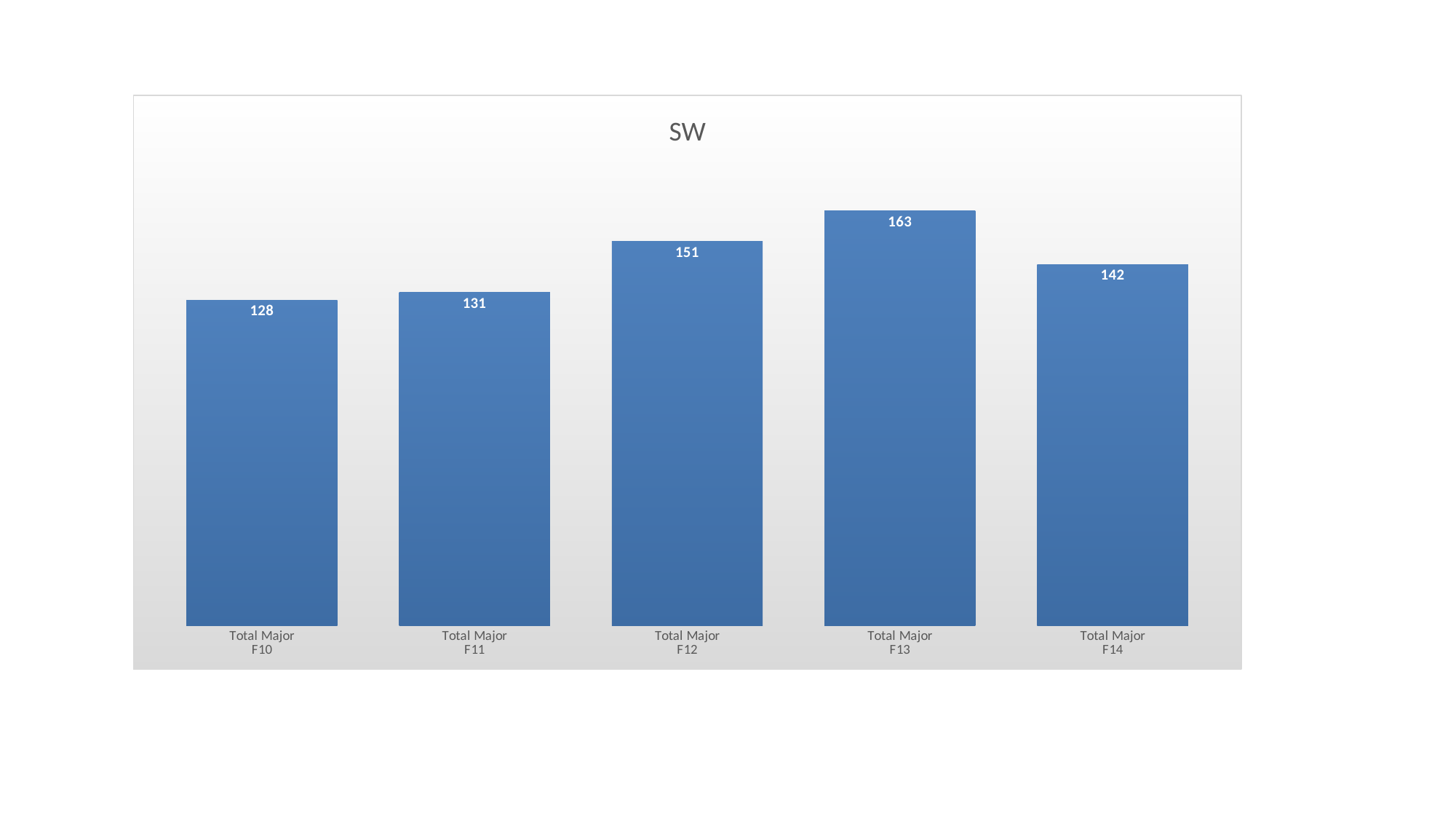
Which category has the lowest value? Total Major F10 What is the value for Total Major F10? 128 Do the values rise or fall from Total Major F10 to Total Major F13? Rise What is the value for Total Major F14? 142 Which is larger, the value for Total Major F12 or Total Major F14? Total Major F12 What is the difference between the values for Total Major F12 and Total Major F11? 20 What kind of chart is shown on the slide? Bar chart How many categories are shown in the chart? 5 What is the title of the chart? SW Which category has the highest value? Total Major F13 What is the difference between the values for Total Major F13 and Total Major F10? 35 What is the value for Total Major F13? 163